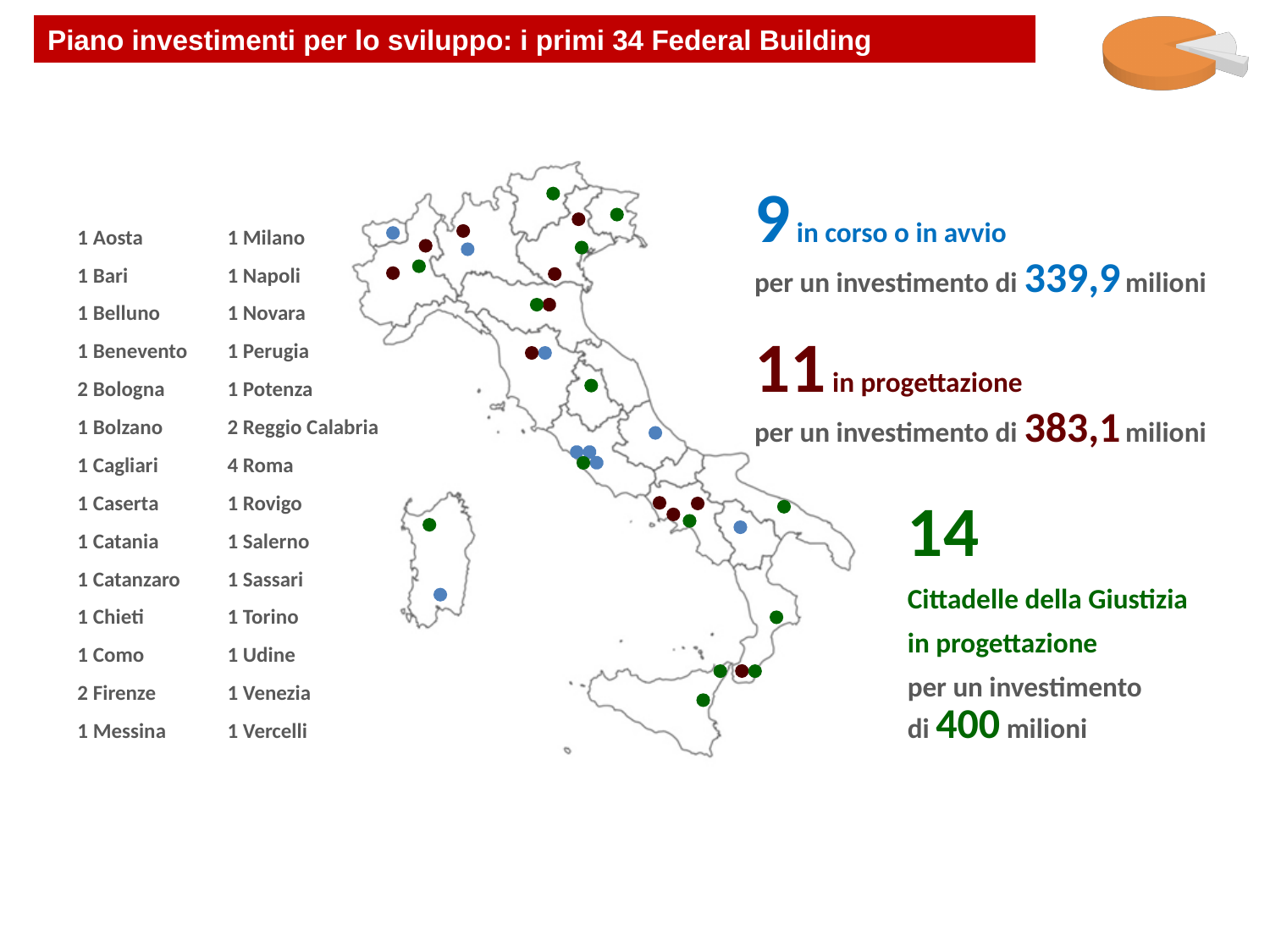
What is the investment for the 14 Cittadelle della Giustizia? 400 milioni What is the difference between the investment for projects in progettazione (383,1 milioni) and for projects in corso o in avvio (339,9 milioni)? 43,2 milioni How many Cittadelle della Giustizia are in progettazione? 14 According to the city list, how many Federal Buildings are in Roma? 4 Which of the three groups has the smallest number of projects? in corso o in avvio (9) What kind of visualization is used to show the locations of the Federal Buildings? a map of Italy with coloured dots What is the investment for the 9 projects in corso o in avvio? 339,9 milioni How many Federal Building projects are listed as 'in progettazione'? 11 What is the total number of projects across the three groups (9, 11 and 14)? 34 What is the investment for the 11 projects in progettazione? 383,1 milioni How many Federal Building projects are listed as 'in corso o in avvio'? 9 Which of the three groups has the largest investment? Cittadelle della Giustizia (400 milioni)